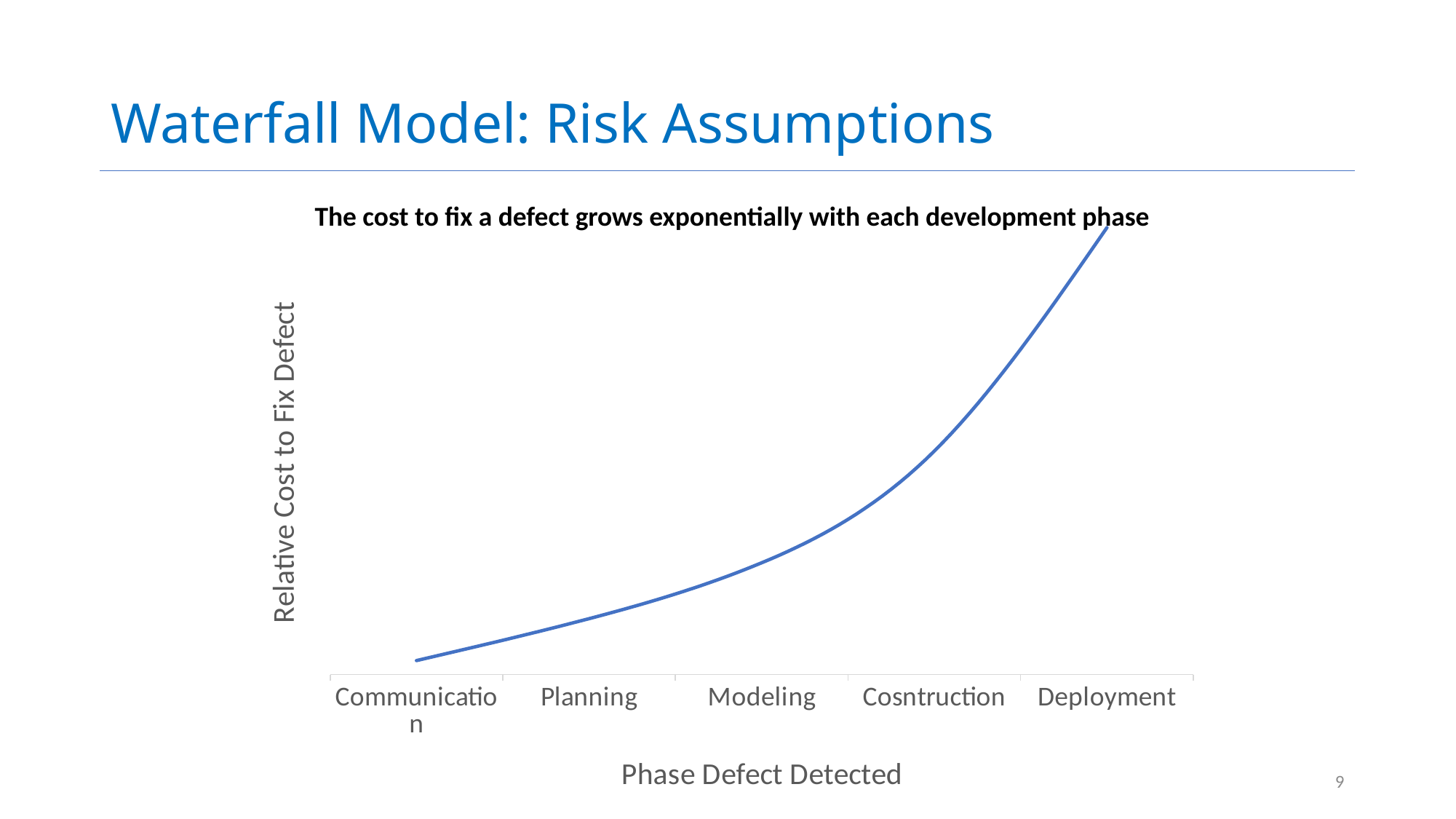
Which phase has the lowest relative cost to fix a defect? Communication Which phase comes immediately after Planning on the x axis? Modeling Which phase has a higher relative cost to fix a defect, Planning or Cosntruction? Cosntruction What is the title of the chart? The cost to fix a defect grows exponentially with each development phase Which phase has a lower relative cost to fix a defect, Modeling or Deployment? Modeling Does the relative cost to fix a defect rise or fall from Communication to Deployment? rise Which phase has the highest relative cost to fix a defect? Deployment What kind of chart is shown on the slide? line chart How many phases are shown along the x axis of the chart? 5 What is the label of the vertical axis of the chart? Relative Cost to Fix Defect